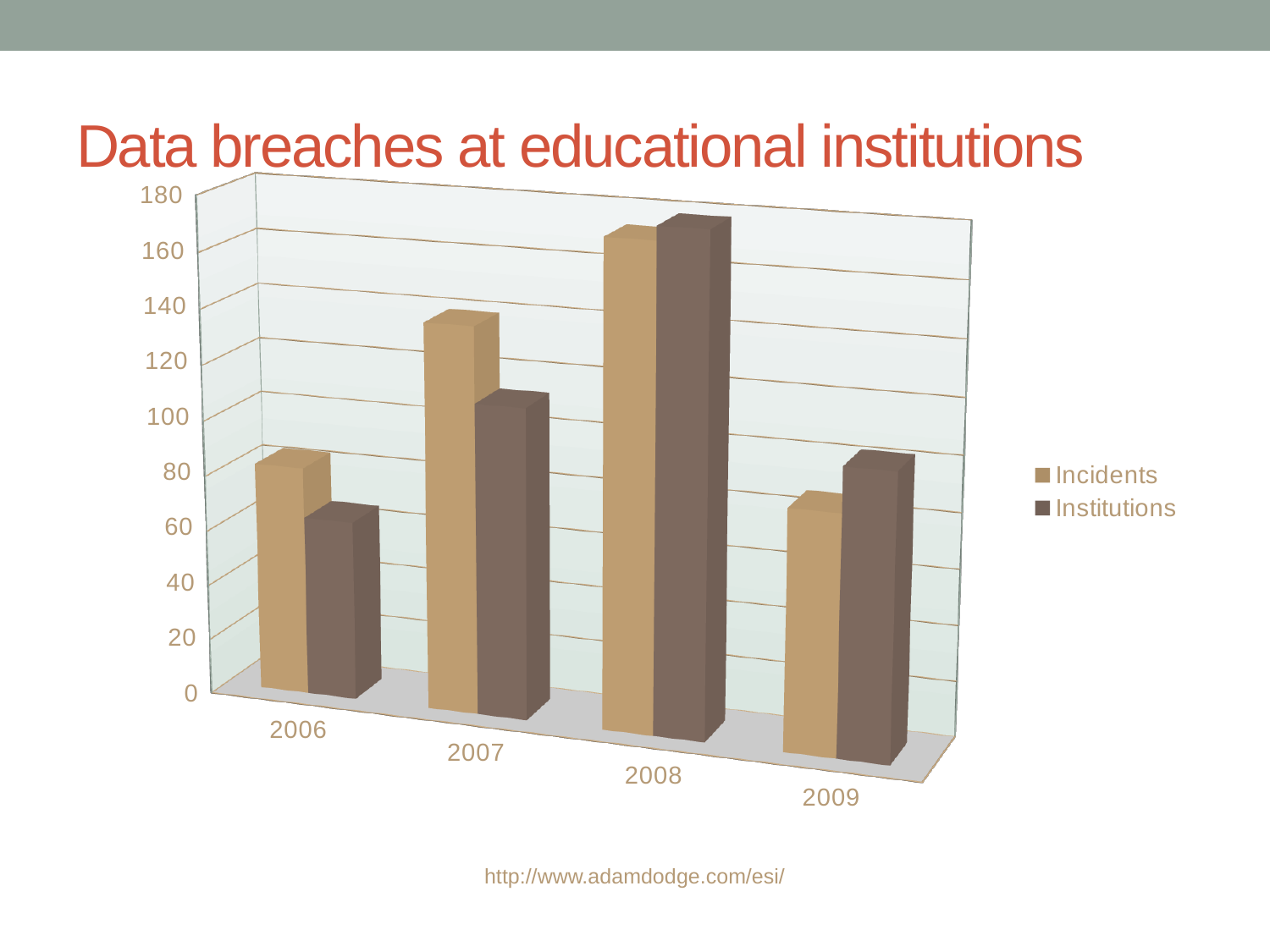
Which year has the lowest value for Institutions? 2006 What kind of chart is shown on the slide? Bar chart How many series does the legend list? 2 What is the title of the chart? Data breaches at educational institutions Which year has the highest value for Incidents? 2008 Do the Incidents values rise or fall from 2006 to 2008? rise In 2007, which is larger, Incidents or Institutions? Incidents Is the value for Institutions in 2006 greater or less than 80? less How many years are shown on the x axis? 4 Which year has the highest value for Institutions? 2008 Is the value for Incidents in 2007 greater or less than 120? greater